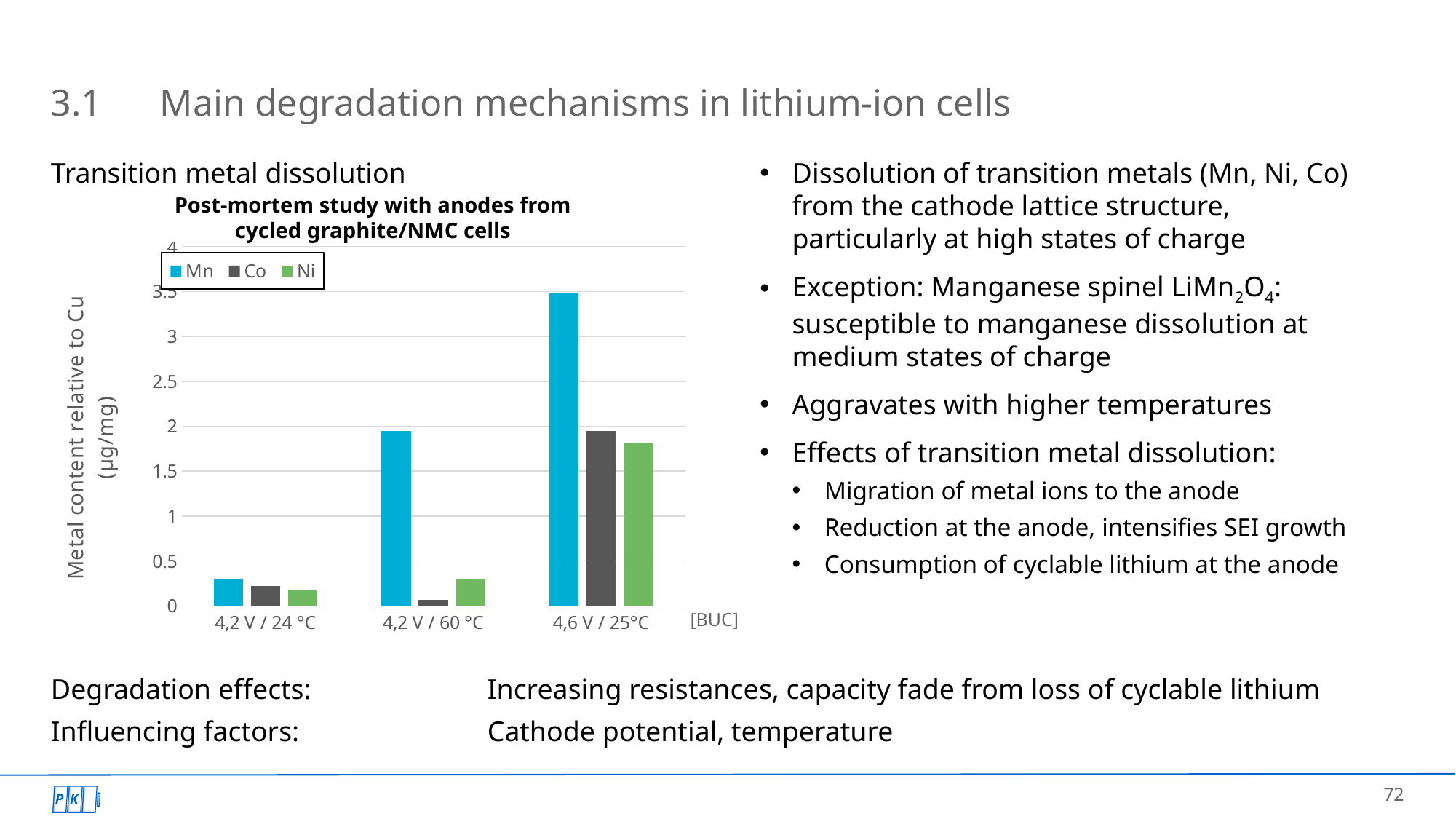
What is the title of the chart? Post-mortem study with anodes from cycled graphite/NMC cells Is the Ni value for 4,6 V / 25°C greater or less than 1.5? greater Which category has the highest Mn value? 4,6 V / 25°C Which series are listed in the chart's legend? Mn, Co, Ni Is the Co value for 4,2 V / 24 °C greater or less than 0.5? less How many categories are shown on the x axis of the chart? 3 Does the Mn value rise or fall across the categories from left to right? rise What kind of chart is shown on the slide? bar chart For 4,2 V / 60 °C, which is larger, the Mn value or the Co value? Mn How many series does the chart's legend list? 3 Which category has the lowest Co value? 4,2 V / 60 °C Is the Mn value for 4,6 V / 25°C greater or less than 3? greater